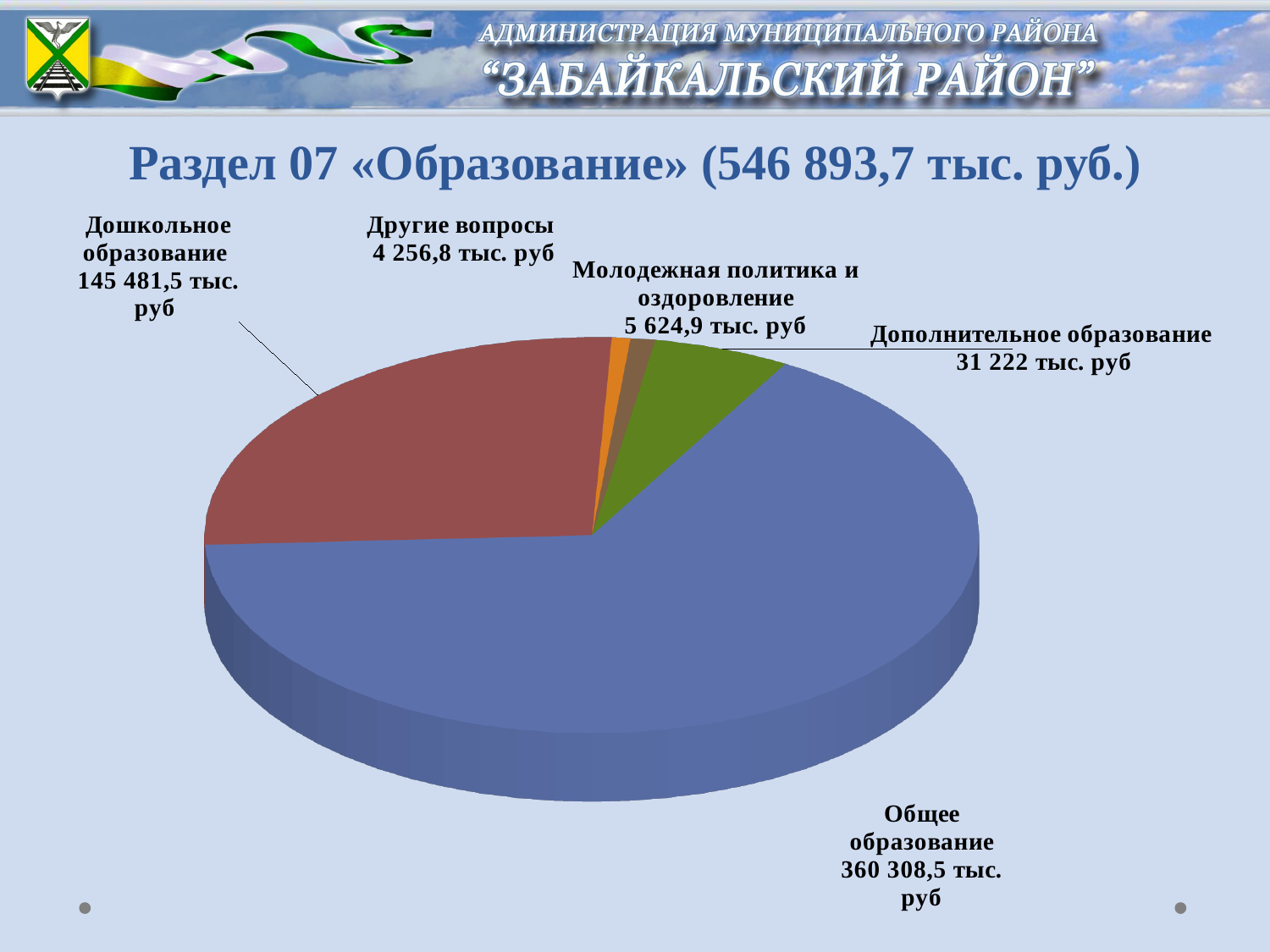
What is the difference between Общее образование and Дошкольное образование? 214 827 тыс. руб What is the value for Дополнительное образование? 31 222 тыс. руб What is the value for Молодежная политика и оздоровление? 5 624,9 тыс. руб Which category has the largest slice of the pie? Общее образование Which category has the smallest slice of the pie? Другие вопросы How many slices does the pie chart have? 5 Which is larger: Дополнительное образование or Молодежная политика и оздоровление? Дополнительное образование What is the value for Другие вопросы? 4 256,8 тыс. руб What is the value for Общее образование? 360 308,5 тыс. руб What type of chart is shown on the slide? Pie chart What is the value for Дошкольное образование? 145 481,5 тыс. руб What total amount is given in the chart title for Раздел 07 «Образование»? 546 893,7 тыс. руб.